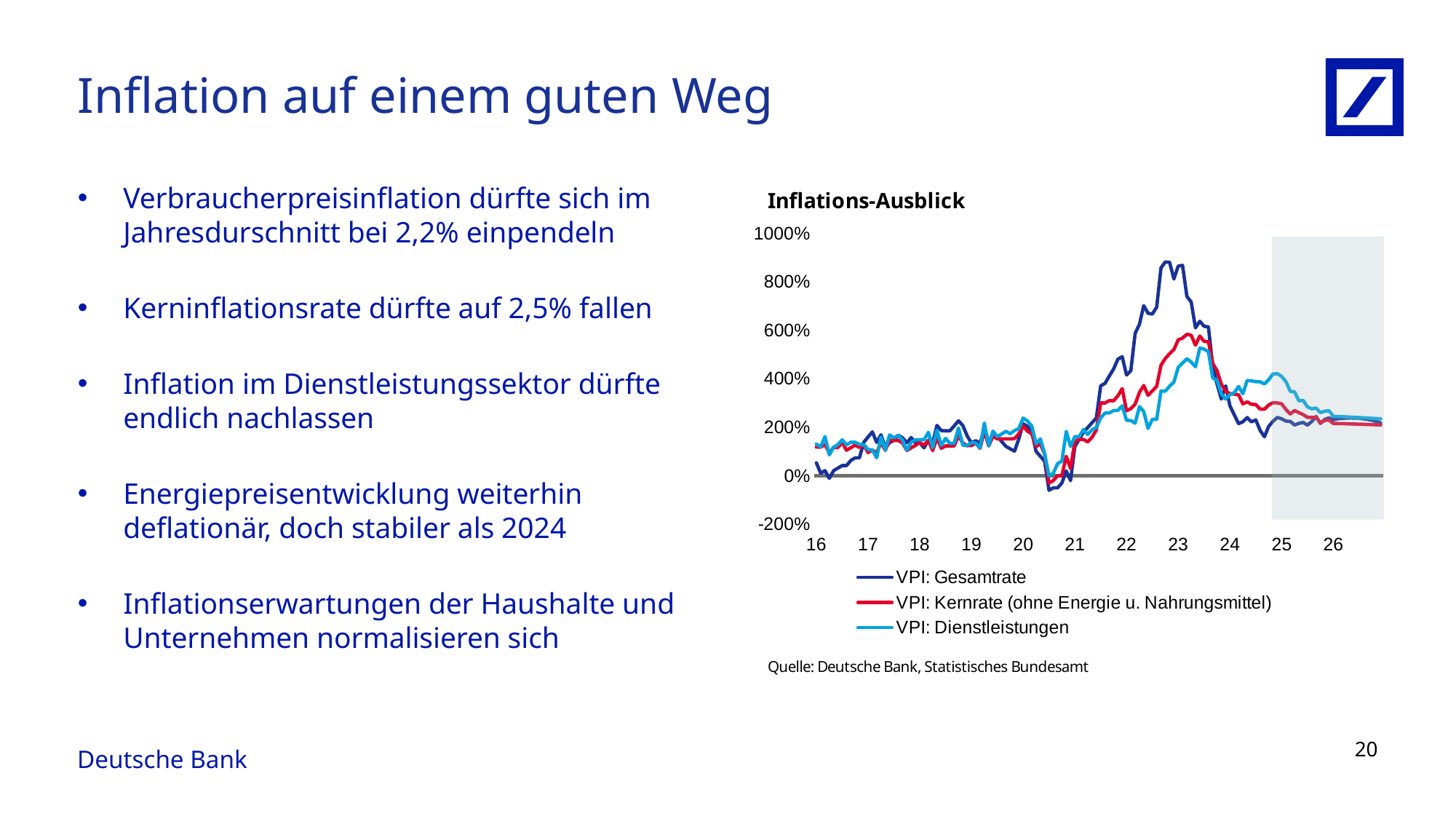
Does VPI: Gesamtrate rise or fall between 23 and 25? fall Which series reaches the lowest value in the "Inflations-Ausblick" chart? VPI: Gesamtrate What is the title of the chart on the slide? Inflations-Ausblick How many series does the legend of the "Inflations-Ausblick" chart list? 3 Is the lowest value of VPI: Gesamtrate around 20 greater or less than 0%? less Is the peak value of VPI: Gesamtrate around 23 greater or less than 800%? greater Which series reaches the highest value in the "Inflations-Ausblick" chart? VPI: Gesamtrate What kind of chart is shown under the title "Inflations-Ausblick"? line chart How many year labels are shown on the x axis of the "Inflations-Ausblick" chart? 11 At its peak around 23, which is larger: VPI: Gesamtrate or VPI: Kernrate (ohne Energie u. Nahrungsmittel)? VPI: Gesamtrate Which series in the "Inflations-Ausblick" chart is drawn in red? VPI: Kernrate (ohne Energie u. Nahrungsmittel)